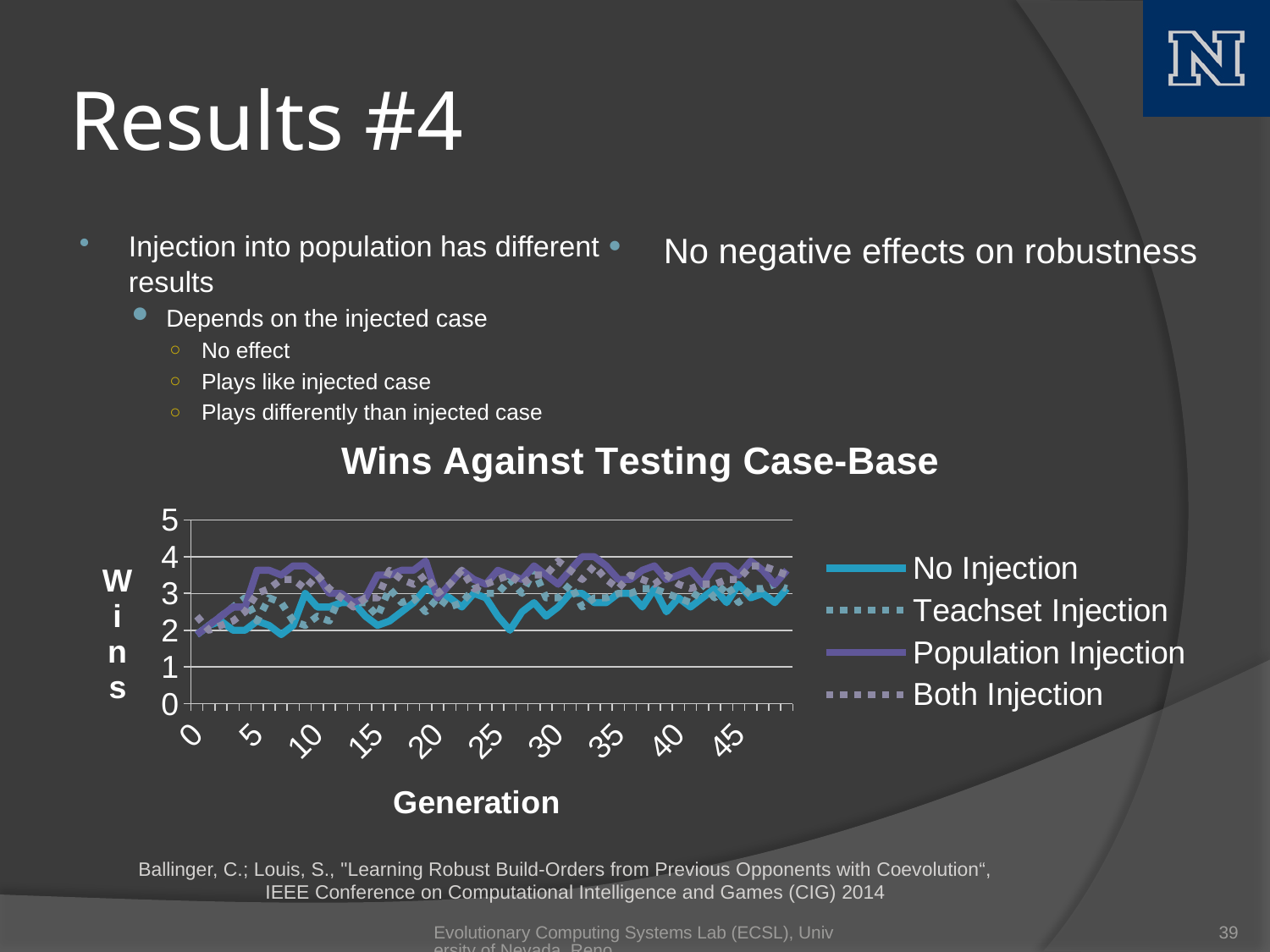
Is the value for Population Injection at generation 10 greater or less than 3? greater Is the value for No Injection at generation 25 greater or less than 3? less How many series does the chart's legend list? 4 Is the value for Population Injection at generation 5 greater or less than 3? greater What is the title of the chart? Wins Against Testing Case-Base What kind of chart is shown on the slide? line chart What label is shown on the x axis of the chart? Generation Does the No Injection series generally rise or fall from generation 0 to generation 45? rise At generation 5, which series has the larger value: Population Injection or No Injection? Population Injection Does the Population Injection series generally rise or fall from generation 0 to generation 10? rise